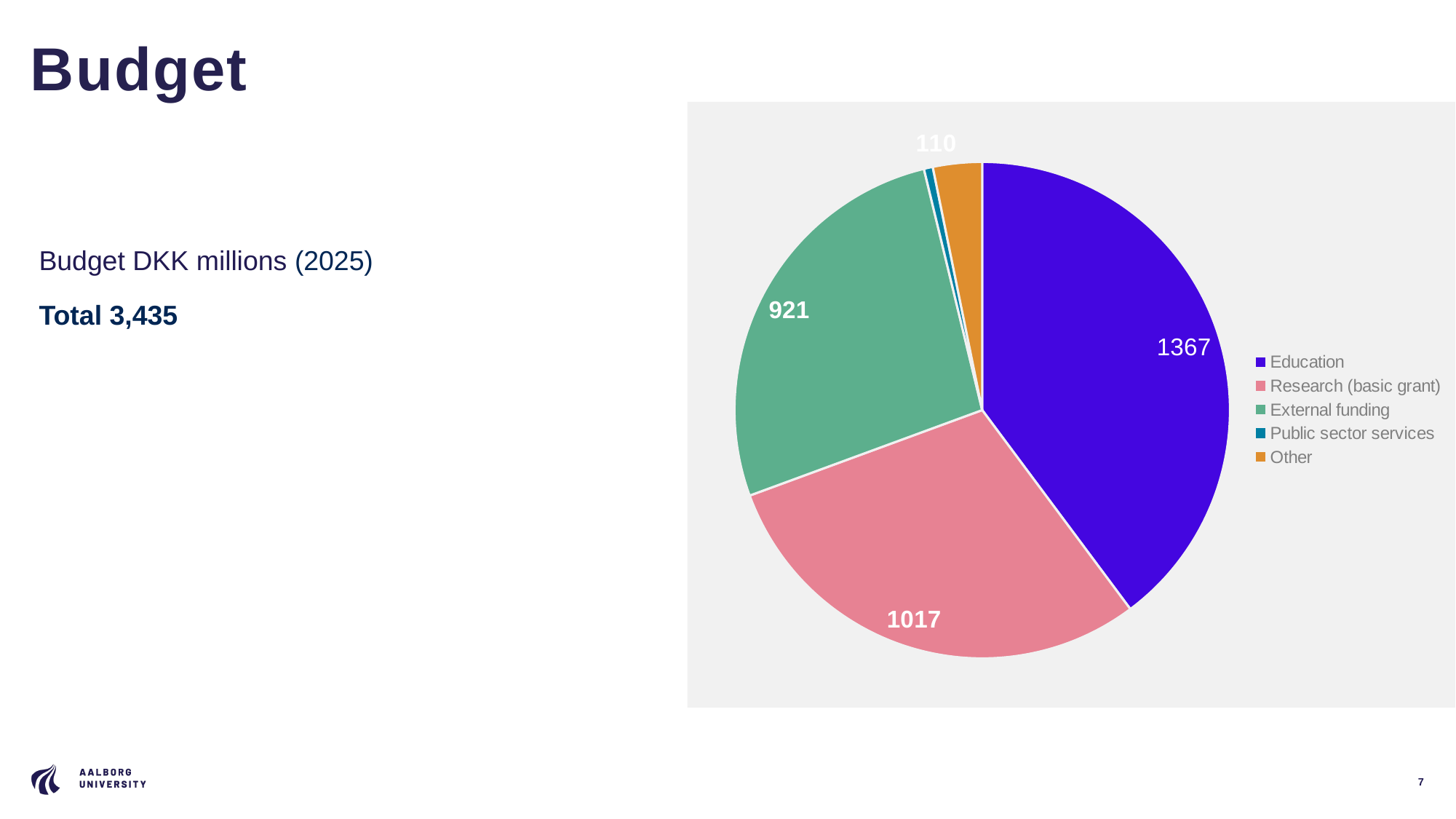
What is the value for Research (basic grant) in the pie chart? 1017 Which category has the smallest slice in the pie chart? Public sector services Which is larger, External funding or Other? External funding Which category has the largest slice in the pie chart? Education What is the value for Other in the pie chart? 110 What is the value for External funding in the pie chart? 921 What is the difference between the Education value and the Research (basic grant) value? 350 How many categories does the pie chart show? 5 What colour is the External funding slice in the pie chart? Green What kind of chart is shown on the slide? Pie chart What is the value for Education in the pie chart? 1367 What is the difference between the Research (basic grant) value and the External funding value? 96